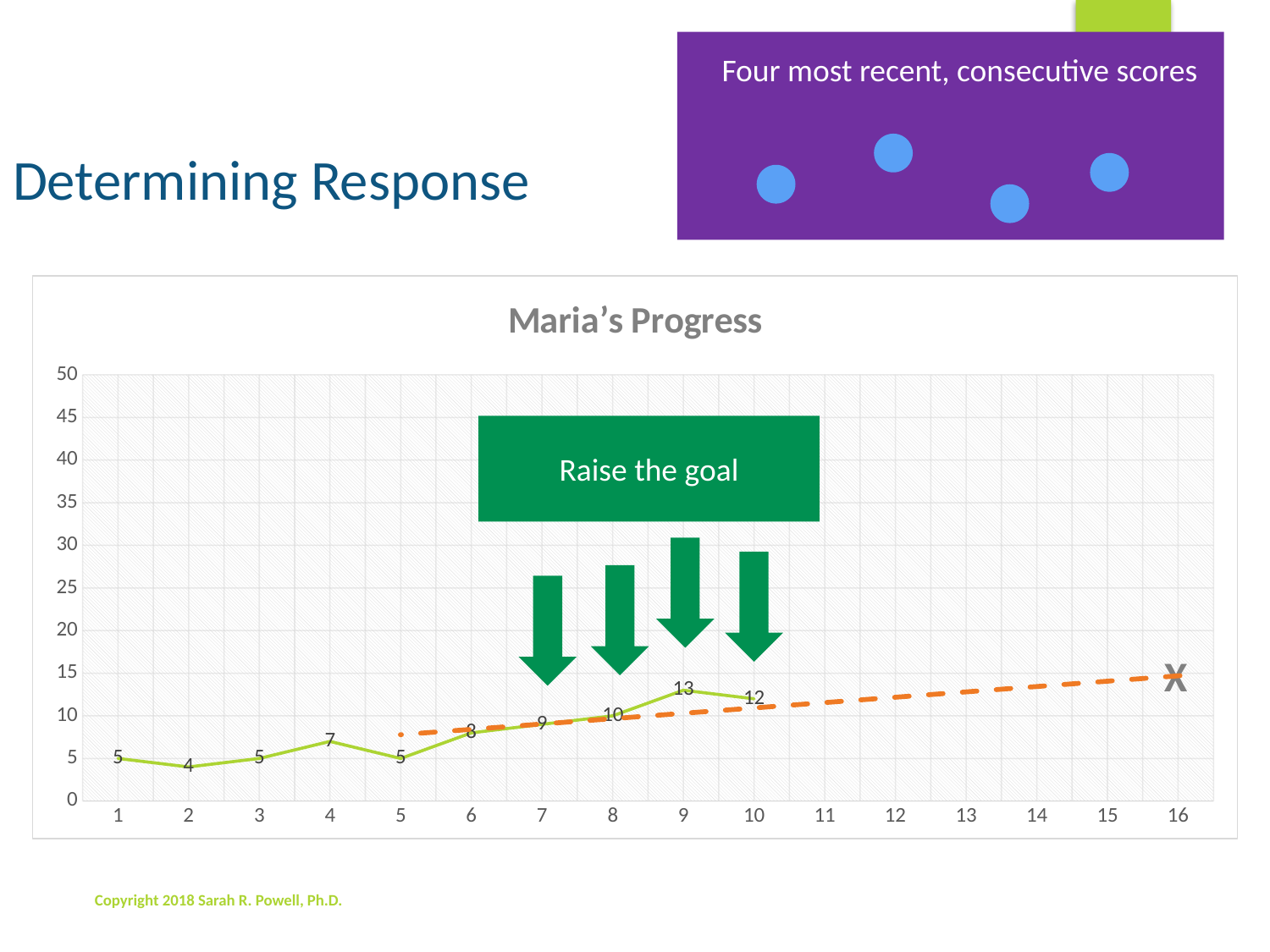
Which is larger, Maria's score at point 4 or at point 5? point 4 Do Maria's scores generally rise or fall from point 5 to point 9? rise What is Maria's score at point 6? 8 At which point is Maria's score highest? 9 At which point is Maria's score lowest? 2 How many data points have scores plotted on the line? 10 What is Maria's score at point 9? 13 What is the difference between Maria's score at point 9 and her score at point 10? 1 What is Maria's score at point 2? 4 What is the title of the chart? Maria's Progress Is Maria's score at point 8 greater or less than 15? less What type of chart is shown on the slide? line chart